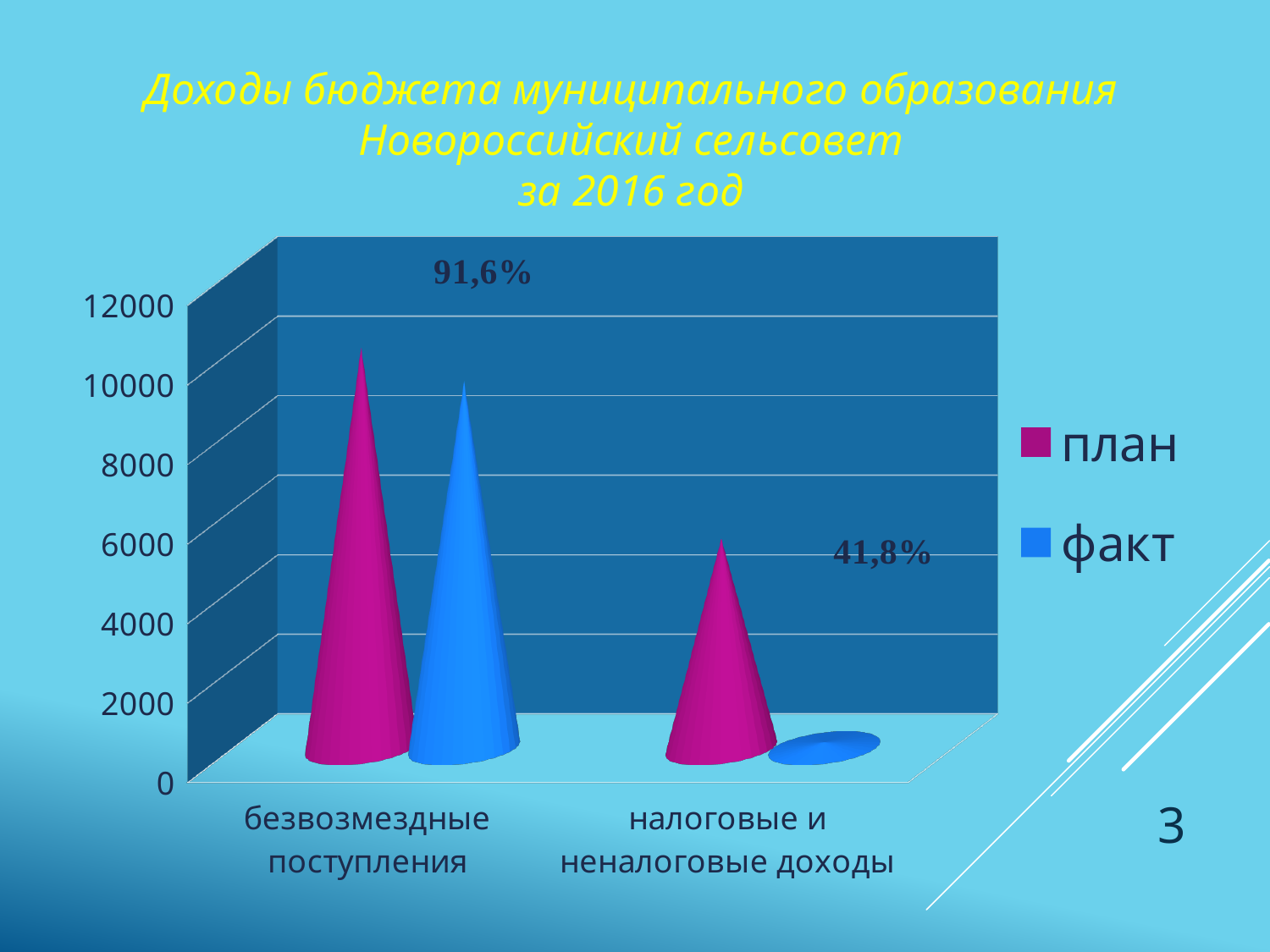
What are the two series named in the legend? план, факт For безвозмездные поступления, which is larger: план or факт? план What kind of chart is shown on the slide? bar chart Is the план value for безвозмездные поступления greater or less than 8000? greater For налоговые и неналоговые доходы, which is larger: план or факт? план Which category has the lowest факт value? налоговые и неналоговые доходы Is the план value for налоговые и неналоговые доходы greater or less than 8000? less Is the факт value for безвозмездные поступления greater or less than 8000? greater How many categories are shown on the x axis of the chart? 2 Which category has the highest план value? безвозмездные поступления How many series does the chart's legend list? 2